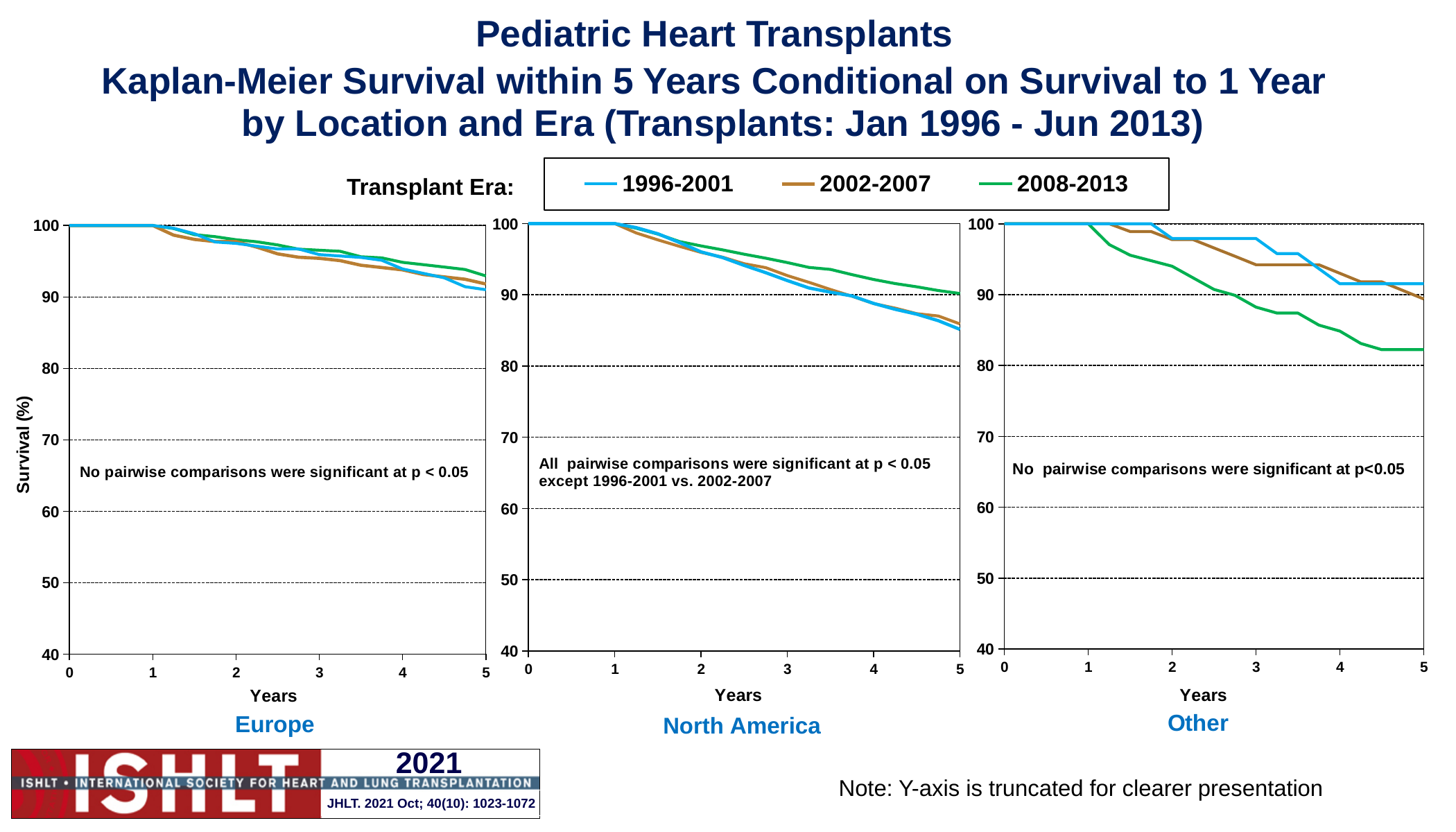
What is the label of the y axis on the Europe chart? Survival (%) In the North America chart, which is larger at year 5: 2008-2013 or 1996-2001? 2008-2013 How many series does the legend list? 3 In the Other chart, which series has the lowest survival at year 5? 2008-2013 What kind of chart is the Europe chart? line chart In the Other chart, which is larger at year 5: 1996-2001 or 2008-2013? 1996-2001 In the North America chart, is the value for 1996-2001 at year 5 greater or less than 90? less In the Other chart, is the value for 2008-2013 at year 5 greater or less than 90? less In the North America chart, do the survival values rise or fall as years increase? fall In the Europe chart, is the value for 2008-2013 at year 5 greater or less than 90? greater How many charts are shown on the slide? 3